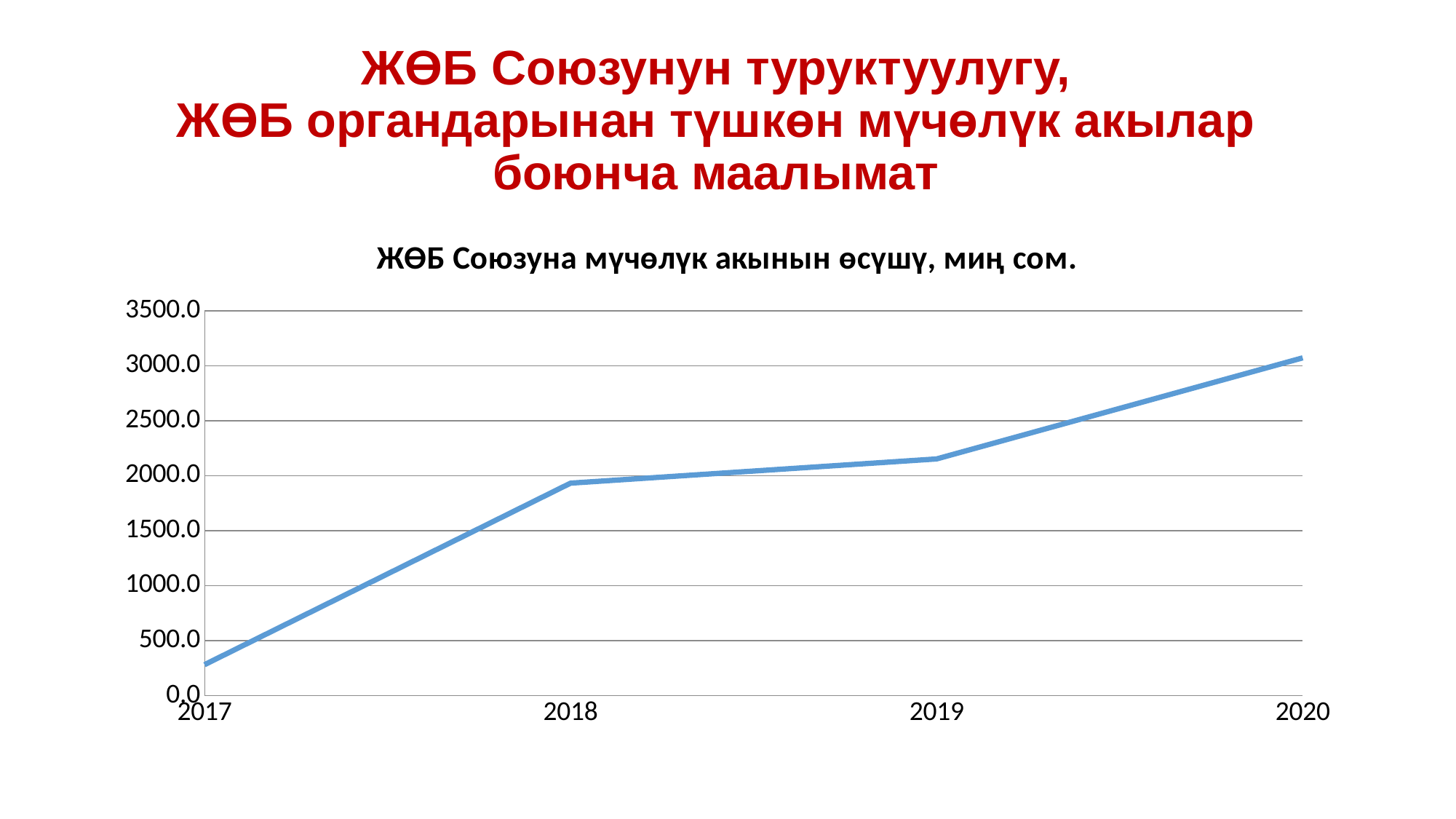
What kind of chart is shown on the slide? line chart Which year has the highest value in the chart? 2020 Is the value for 2020 greater or less than 2500? greater How many years are plotted along the x axis of the chart? 4 Is the value for 2018 greater or less than 1500? greater Do the values in the chart generally rise or fall from 2017 to 2020? rise Is the value for 2017 greater or less than 500? less Which year has the lowest value in the chart? 2017 Which year has the larger value, 2018 or 2020? 2020 What is the title of the chart? ЖӨБ Союзуна мүчөлүк акынын өсүшү, миң сом. What is the highest value shown on the y axis of the chart? 3500.0